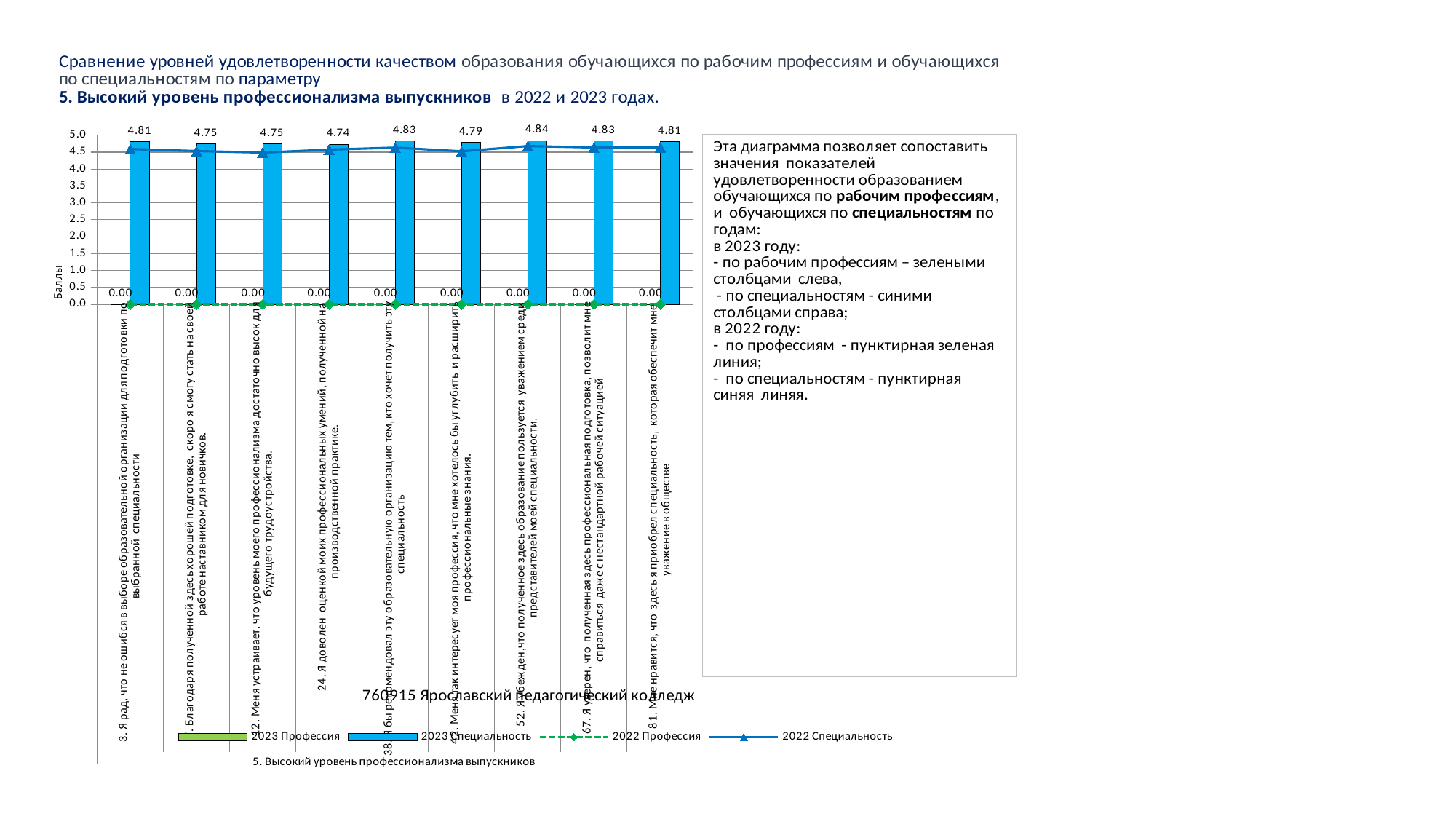
What is the difference between the 2023 Специальность values for item 52 and item 24? 0.10 What is the 2023 Специальность value for item 52 (Я убежден, что полученное здесь образование пользуется уважением среди представителей моей специальности)? 4.84 How many categories (survey items) are shown on the x axis? 9 What is the 2023 Специальность value for item 3 (Я рад, что не ошибся в выборе образовательной организации)? 4.81 What is the 2023 Специальность value for item 24 (Я доволен оценкой моих профессиональных умений, полученной на производственной практике)? 4.74 Which has the larger 2023 Специальность value: item 38 or item 42? 38. Я бы рекомендовал эту образовательную организацию тем, кто хочет получить эту специальность What is the title of the vertical axis? Баллы How many series does the legend list? 4 Is the 2022 Специальность value for item 3 greater or less than 4.0? greater What kind of chart is this? combination bar and line chart Which item has the lowest 2023 Специальность value? 24. Я доволен оценкой моих профессиональных умений, полученной на производственной практике Which item has the highest 2023 Специальность value? 52. Я убежден, что полученное здесь образование пользуется уважением среди представителей моей специальности